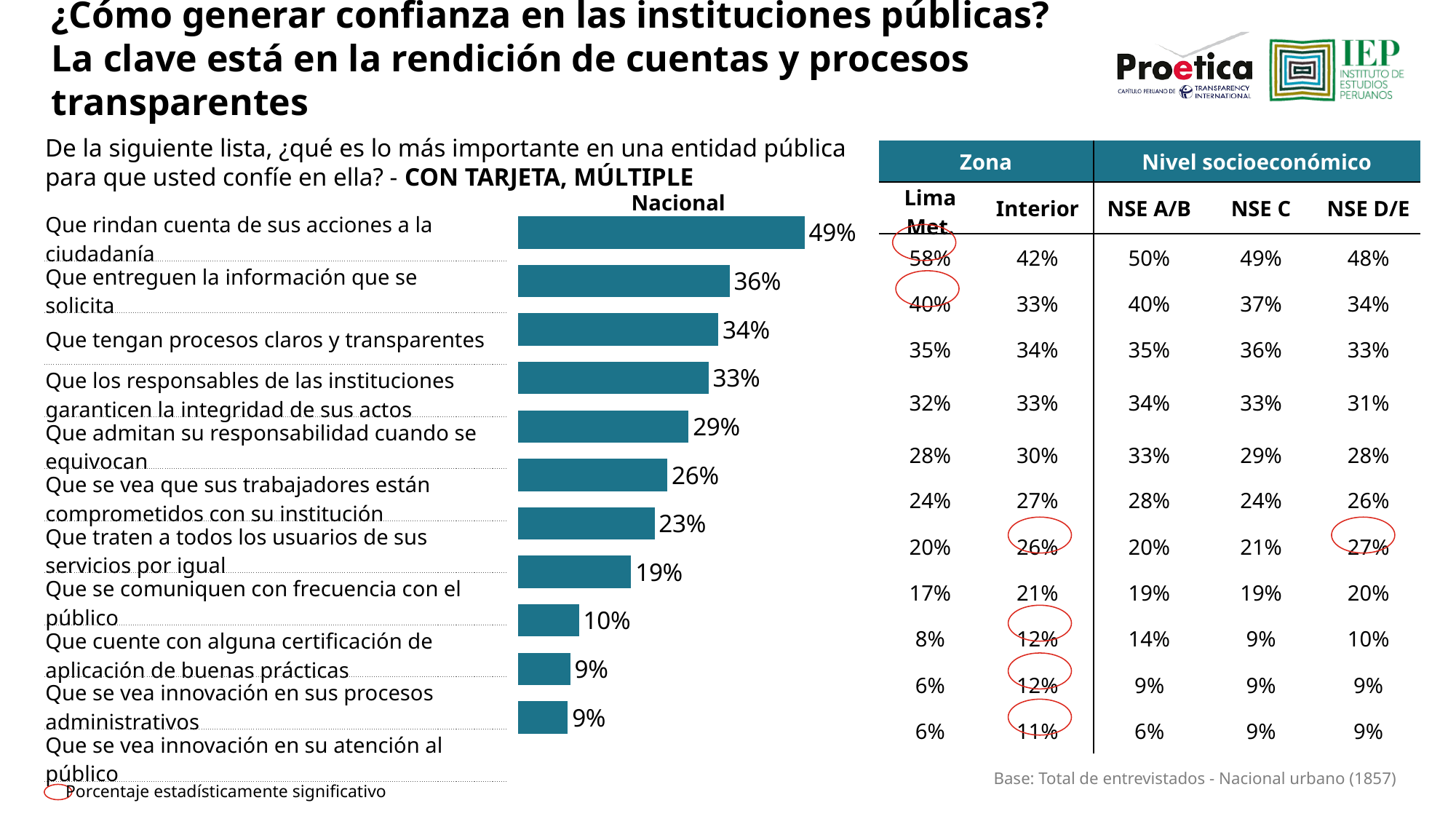
Which is larger: 'Que admitan su responsabilidad cuando se equivocan' or 'Que traten a todos los usuarios de sus servicios por igual'? Que admitan su responsabilidad cuando se equivocan Which category has the highest value in the chart? Que rindan cuenta de sus acciones a la ciudadanía What is the value for 'Que rindan cuenta de sus acciones a la ciudadanía'? 49% What is the title of the chart? Nacional How many categories are plotted in the chart? 11 What is the value for 'Que se comuniquen con frecuencia con el público'? 19% What type of chart is shown on the slide? Bar chart Do the bar values rise or fall from the top of the chart to the bottom? Fall What is the value for 'Que tengan procesos claros y transparentes'? 34% What is the difference between 'Que rindan cuenta de sus acciones a la ciudadanía' and 'Que entreguen la información que se solicita'? 13% What is the lowest value shown in the chart? 9% What is the value for 'Que cuente con alguna certificación de aplicación de buenas prácticas'? 10%